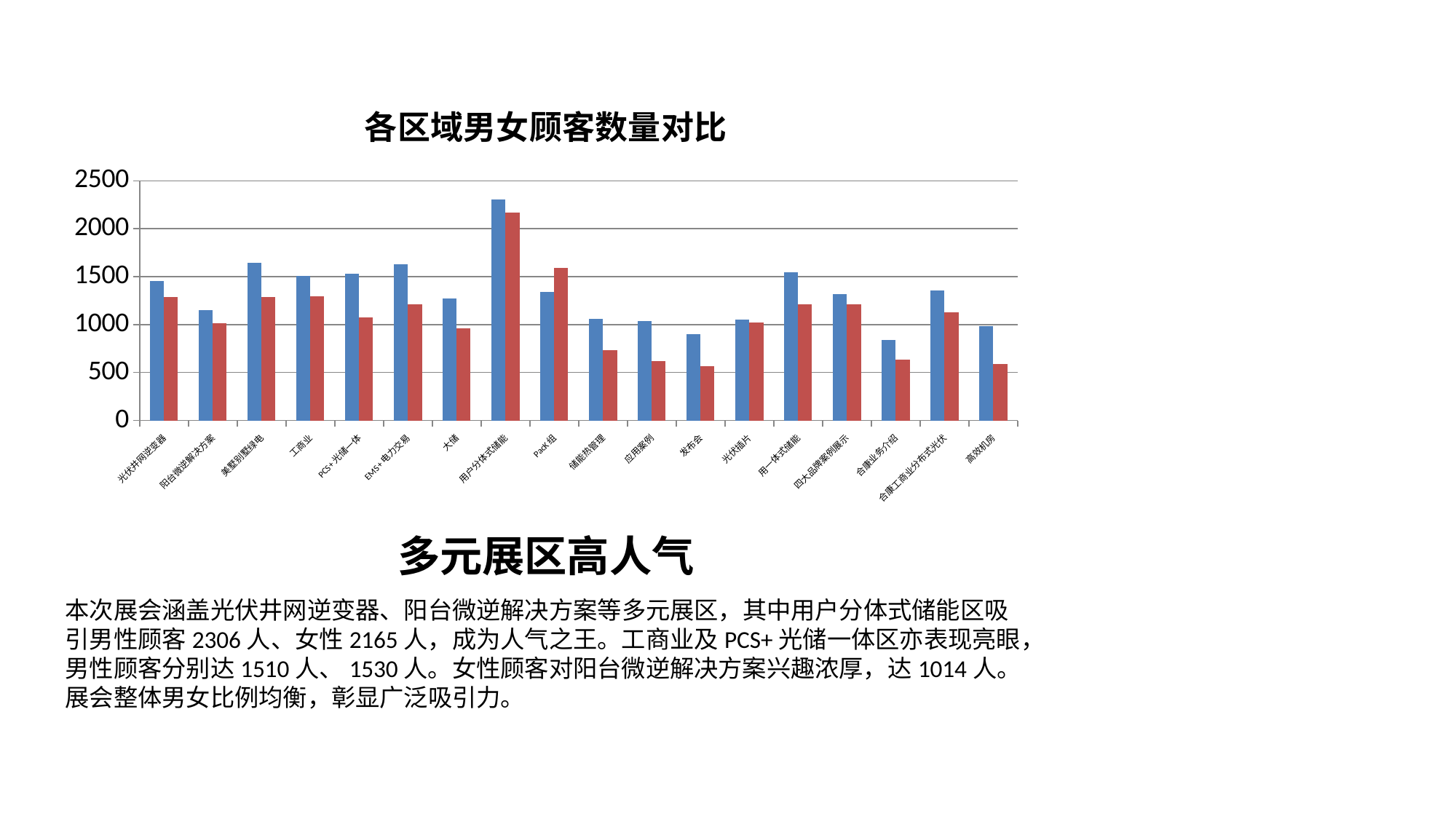
Is the blue bar for 用户分体式储能 greater or less than 2000? greater According to the slide text, how many male customers did the 用户分体式储能 area attract? 2306 人 Which category has the tallest red bar? 用户分体式储能 Is the red bar for 储能热管理 greater or less than 1000? less What is the title of the chart? 各区域男女顾客数量对比 For Pack组, which bar is taller, the blue one or the red one? red For 工商业, which bar is taller, the blue one or the red one? blue Is the blue bar for 美墅别墅绿电 greater or less than 1500? greater What kind of chart is shown on the slide? bar chart Which category has the tallest blue bar? 用户分体式储能 How many categories are shown along the x axis of the chart? 18